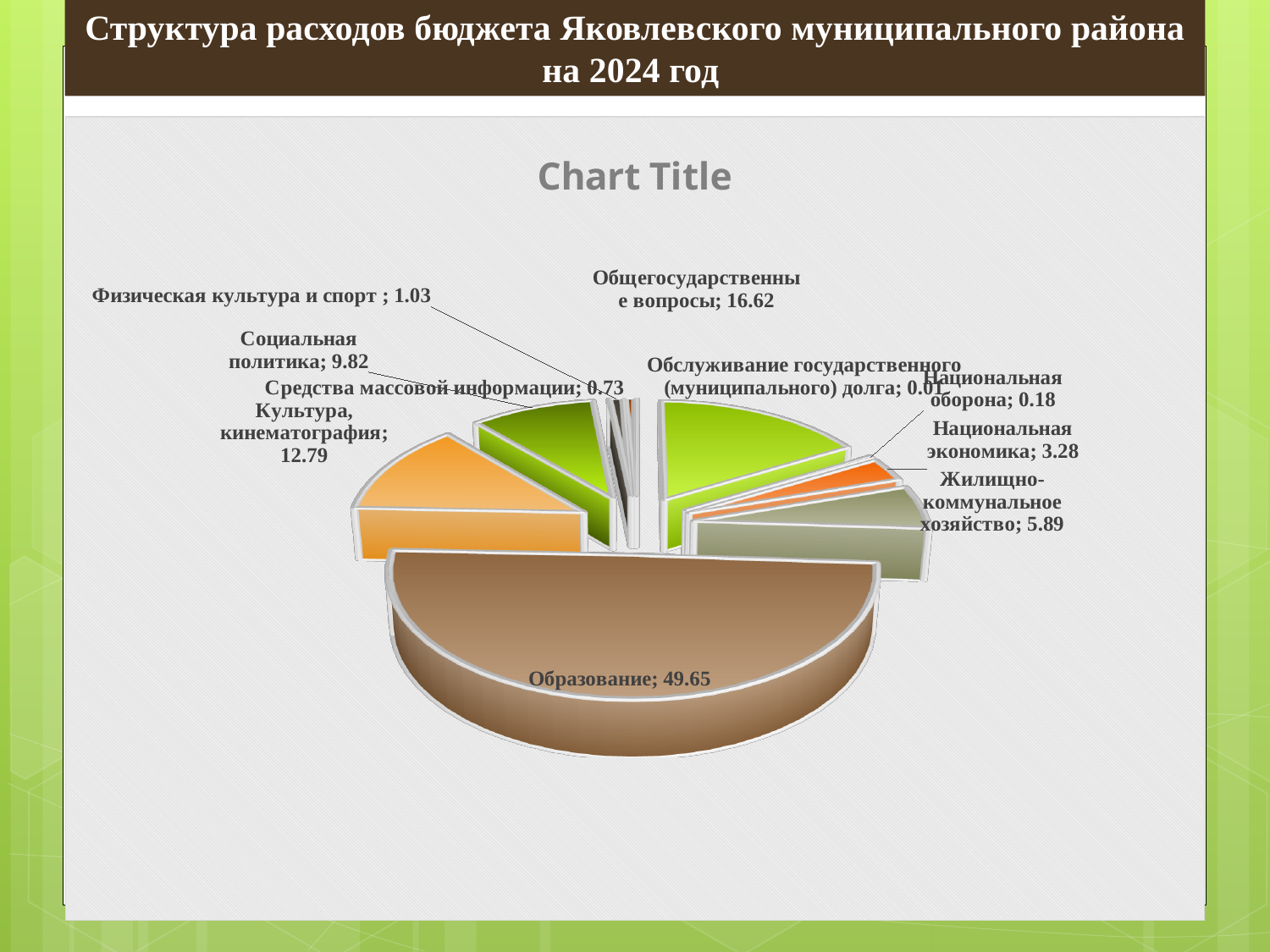
What kind of chart is shown on the slide? pie chart How many categories are shown in the pie chart? 10 Which category has the largest slice of the pie? Образование What is the difference between the values for Образование and Общегосударственные вопросы? 33.03 What is the value for Образование? 49.65 What is the value for Жилищно-коммунальное хозяйство? 5.89 What is the value for Общегосударственные вопросы? 16.62 Which is larger, the value for Национальная экономика or the value for Физическая культура и спорт? Национальная экономика What is the difference between the values for Культура, кинематография and Социальная политика? 2.97 What is the value for Национальная оборона? 0.18 What is the title printed above the pie chart? Chart Title What is the value for Культура, кинематография? 12.79